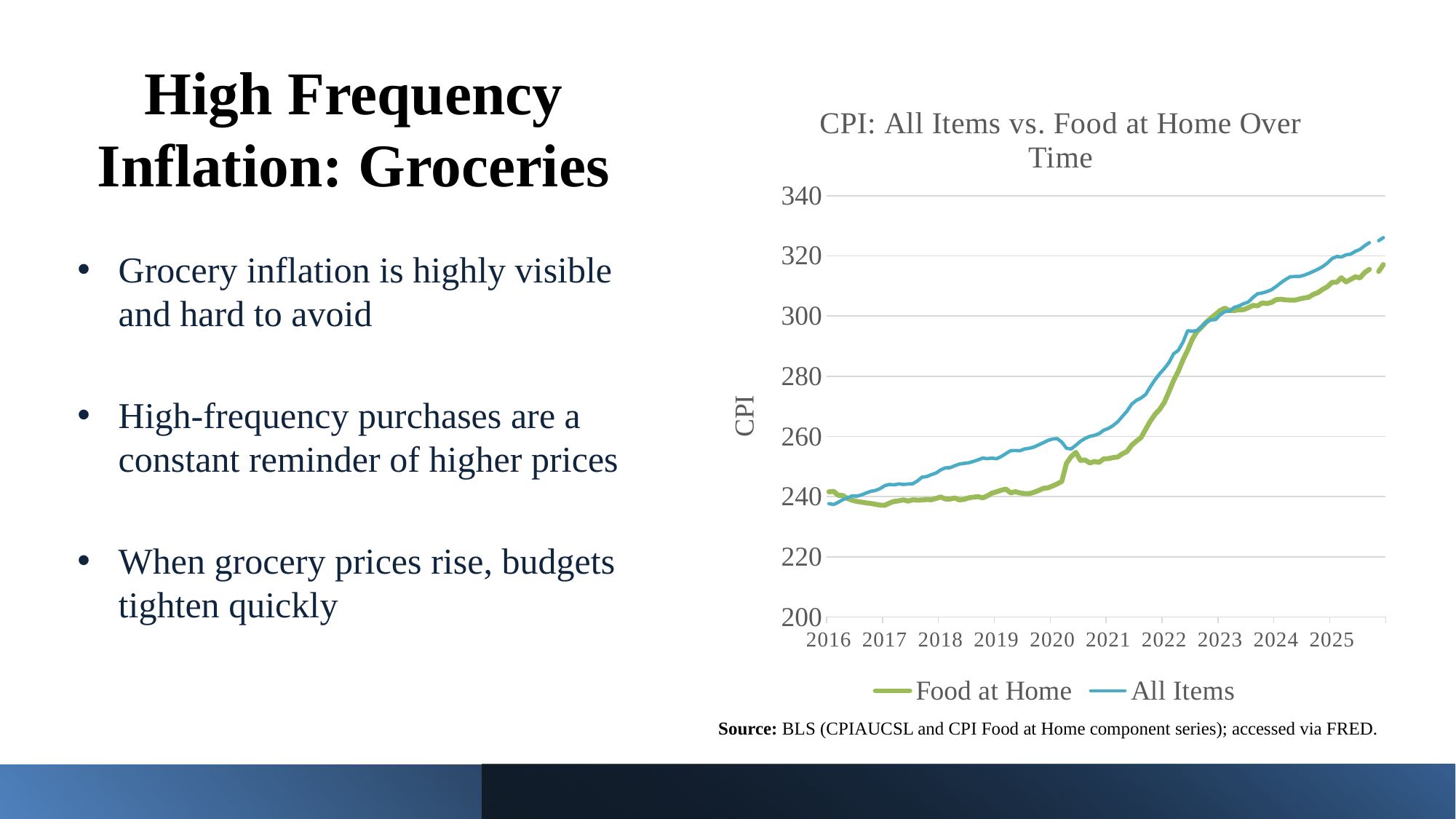
What is the label on the vertical axis of the chart? CPI Is the value for All Items at 2024 greater or less than 300? greater Is the value for Food at Home at 2018 greater or less than 260? less Is the value for Food at Home at 2023 greater or less than 280? greater How many year labels are shown on the horizontal axis? 10 Do the Food at Home values generally rise or fall from 2016 to 2025? Rise How many series does the legend list? 2 What is the title of the chart? CPI: All Items vs. Food at Home Over Time At 2019, which series has the higher value, All Items or Food at Home? All Items What kind of chart is shown on the slide? Line chart Do the All Items values generally rise or fall from 2016 to 2025? Rise